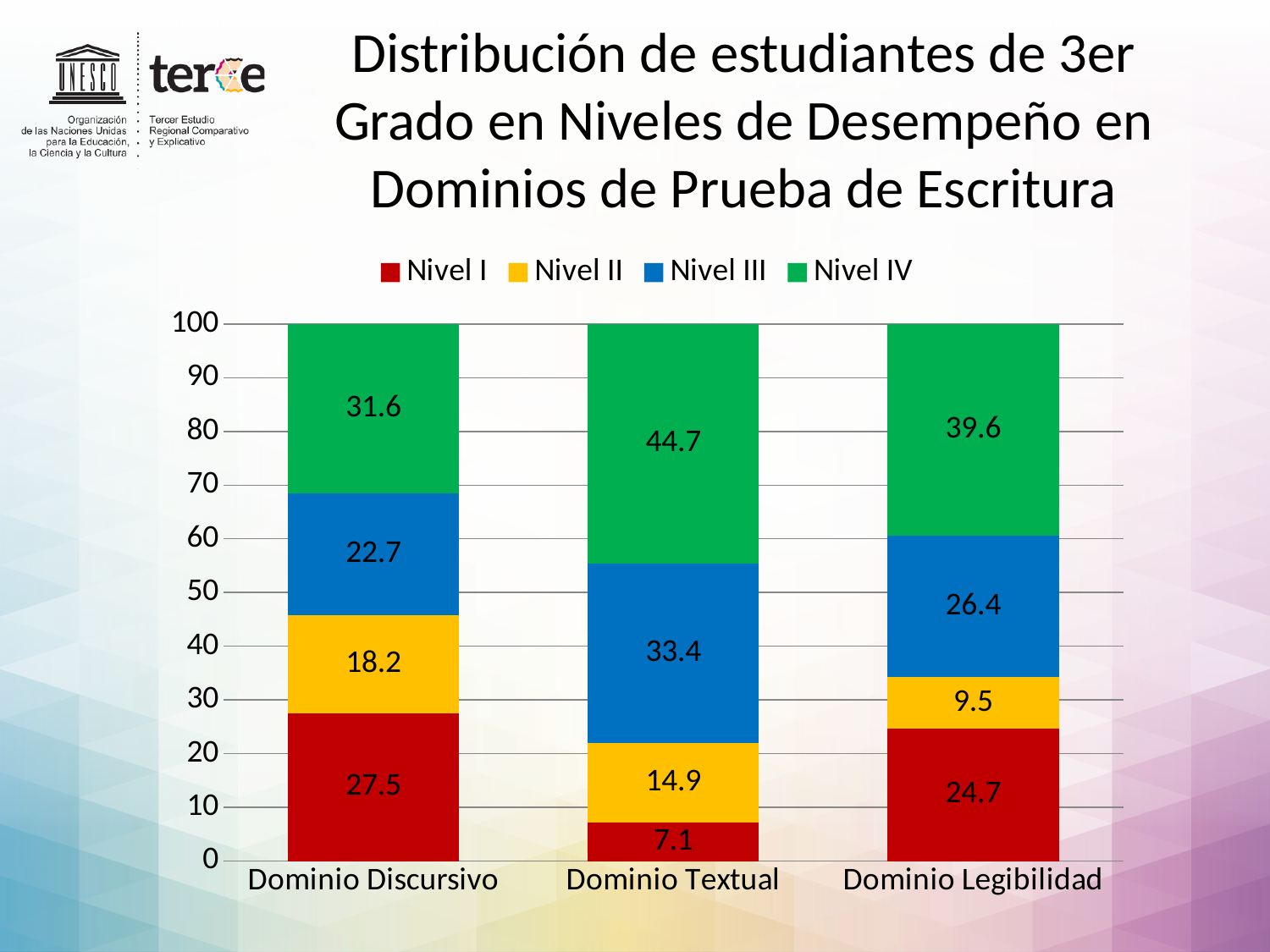
What is the value for Nivel IV in Dominio Legibilidad? 39.6 What is the difference between the Nivel IV values for Dominio Textual and Dominio Discursivo? 13.1 Which category has the lowest value for Nivel I? Dominio Textual How many series does the legend list? 4 Which category has the highest value for Nivel IV? Dominio Textual Which is larger: the Nivel III value for Dominio Textual or for Dominio Legibilidad? Dominio Textual What is the difference between the Nivel II values for Dominio Discursivo and Dominio Legibilidad? 8.7 What is the value for Nivel III in Dominio Discursivo? 22.7 How many categories are shown on the x axis? 3 What is the value for Nivel I in Dominio Textual? 7.1 What kind of chart is shown on the slide? Stacked bar chart Which series is shown in green in the legend? Nivel IV